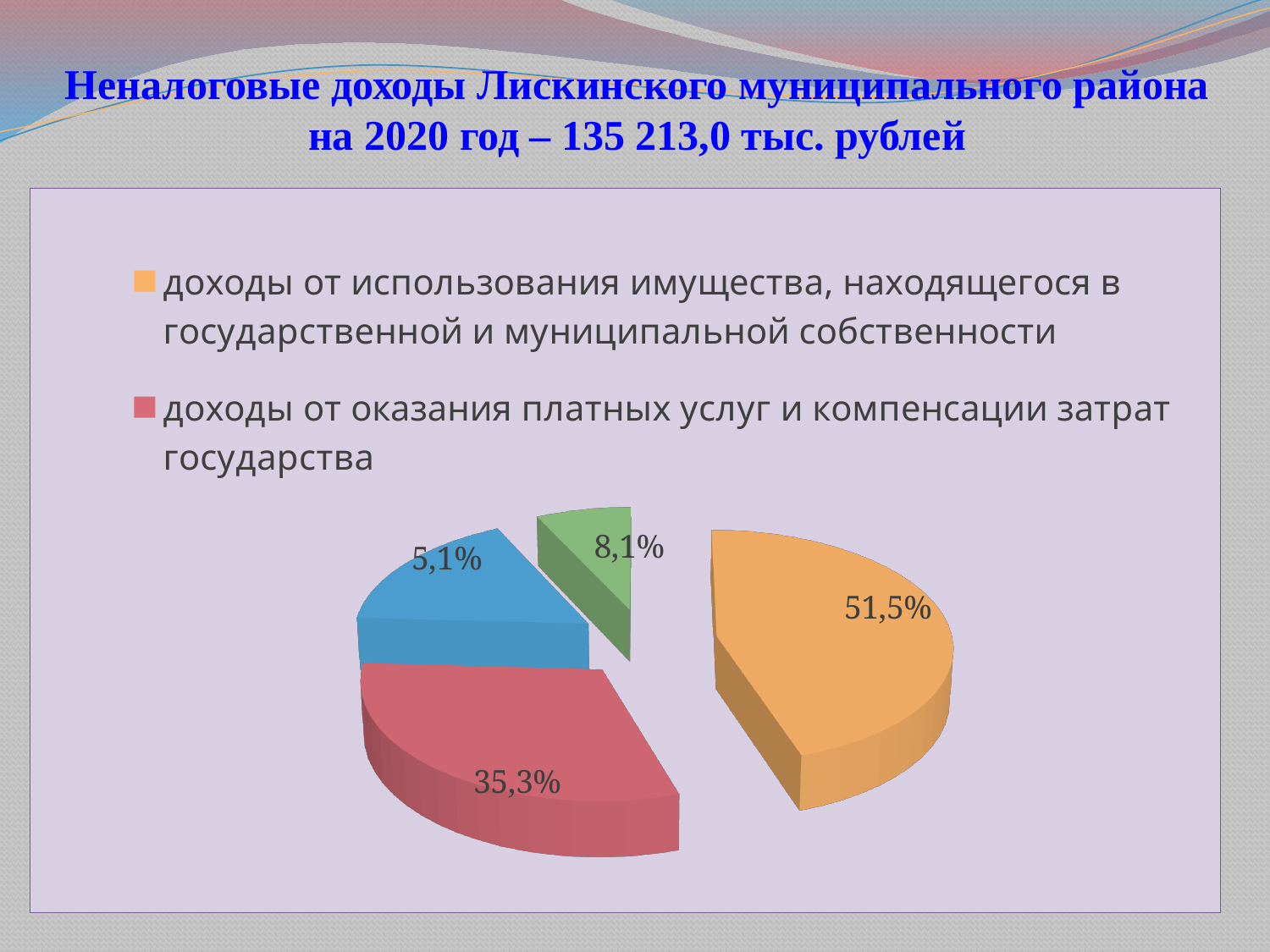
Is the share for "доходы от использования имущества, находящегося в государственной и муниципальной собственности" greater or less than 50%? greater What total amount of non-tax revenue for 2020 is stated in the slide title? 135 213,0 тыс. рублей What is the smallest percentage shown on any slice of the pie chart? 5,1% What colour is the slice for "доходы от оказания платных услуг и компенсации затрат государства"? red Which legend category has the largest slice in the pie chart? доходы от использования имущества, находящегося в государственной и муниципальной собственности How many entries does the chart legend list? 2 By how many percentage points does the slice for "доходы от использования имущества" exceed the slice for "доходы от оказания платных услуг и компенсации затрат государства"? 16,2 What share of the pie chart is labelled for "доходы от использования имущества, находящегося в государственной и муниципальной собственности"? 51,5% What kind of chart is shown on the slide? pie chart How many slices does the pie chart have? 4 Which is larger: the slice for "доходы от оказания платных услуг и компенсации затрат государства" or the slice labelled 8,1%? доходы от оказания платных услуг и компенсации затрат государства What share of the pie chart is labelled for "доходы от оказания платных услуг и компенсации затрат государства"? 35,3%